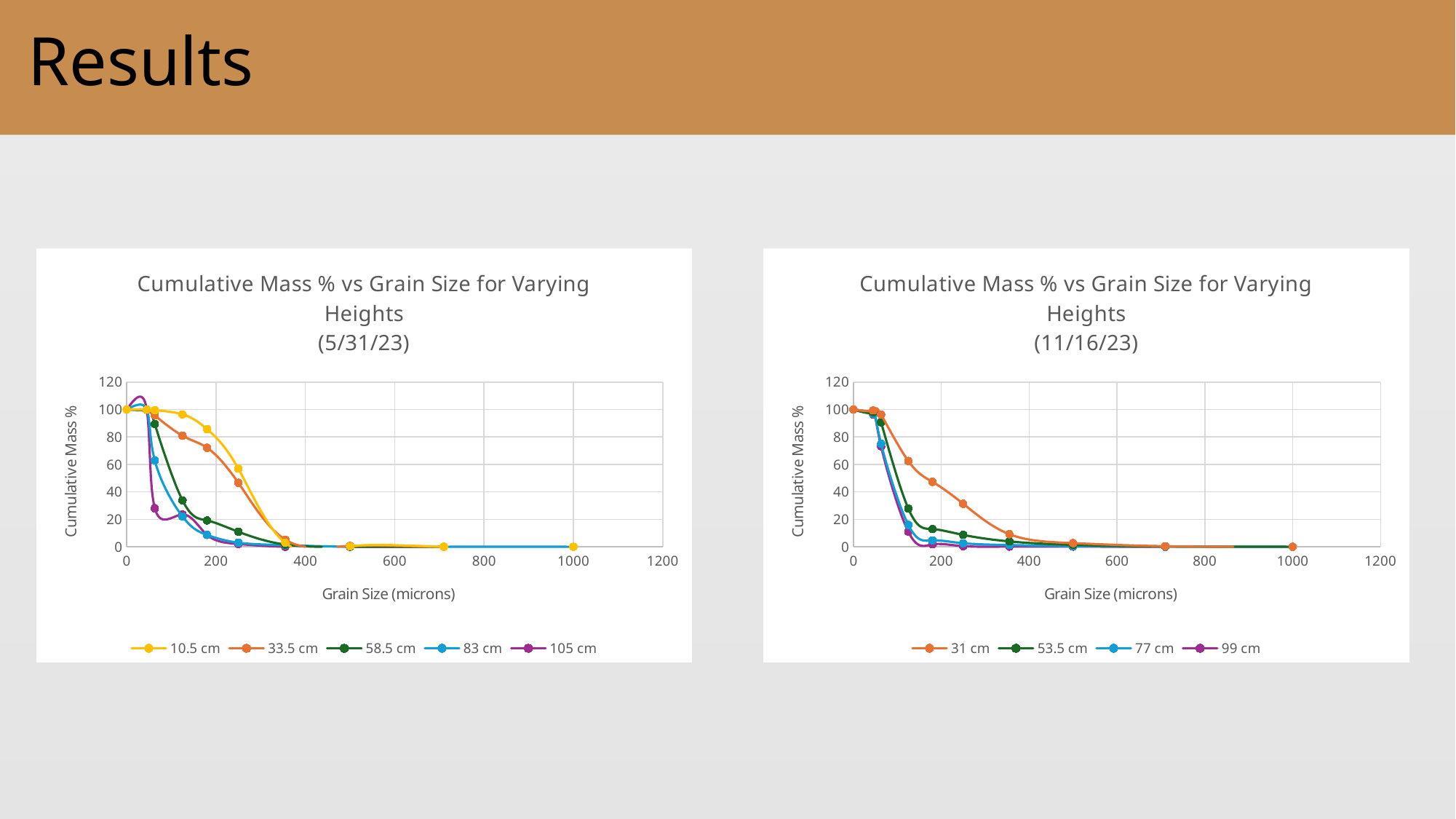
In the left chart (5/31/23), at a grain size of 125 microns, which series has the larger value: 10.5 cm or 58.5 cm? 10.5 cm What type of chart is the left chart titled "Cumulative Mass % vs Grain Size for Varying Heights (5/31/23)"? Line chart In the right chart (11/16/23), at a grain size of 250 microns, which series has the larger value: 31 cm or 99 cm? 31 cm In the left chart (5/31/23), is the value for the 10.5 cm series at a grain size of 250 microns greater or less than 40? greater In the left chart (5/31/23), is the value for the 105 cm series at a grain size of about 60 microns greater or less than 40? less In the right chart (11/16/23), is the value for the 77 cm series at a grain size of 125 microns greater or less than 20? less In the left chart (5/31/23), do the cumulative mass % values rise or fall as grain size increases? Fall How many series does the legend of the left chart (5/31/23) list? 5 In the right chart (11/16/23), do the cumulative mass % values rise or fall as grain size increases? Fall How many series does the legend of the right chart (11/16/23) list? 4 What is the x-axis label of the right chart (11/16/23)? Grain Size (microns)